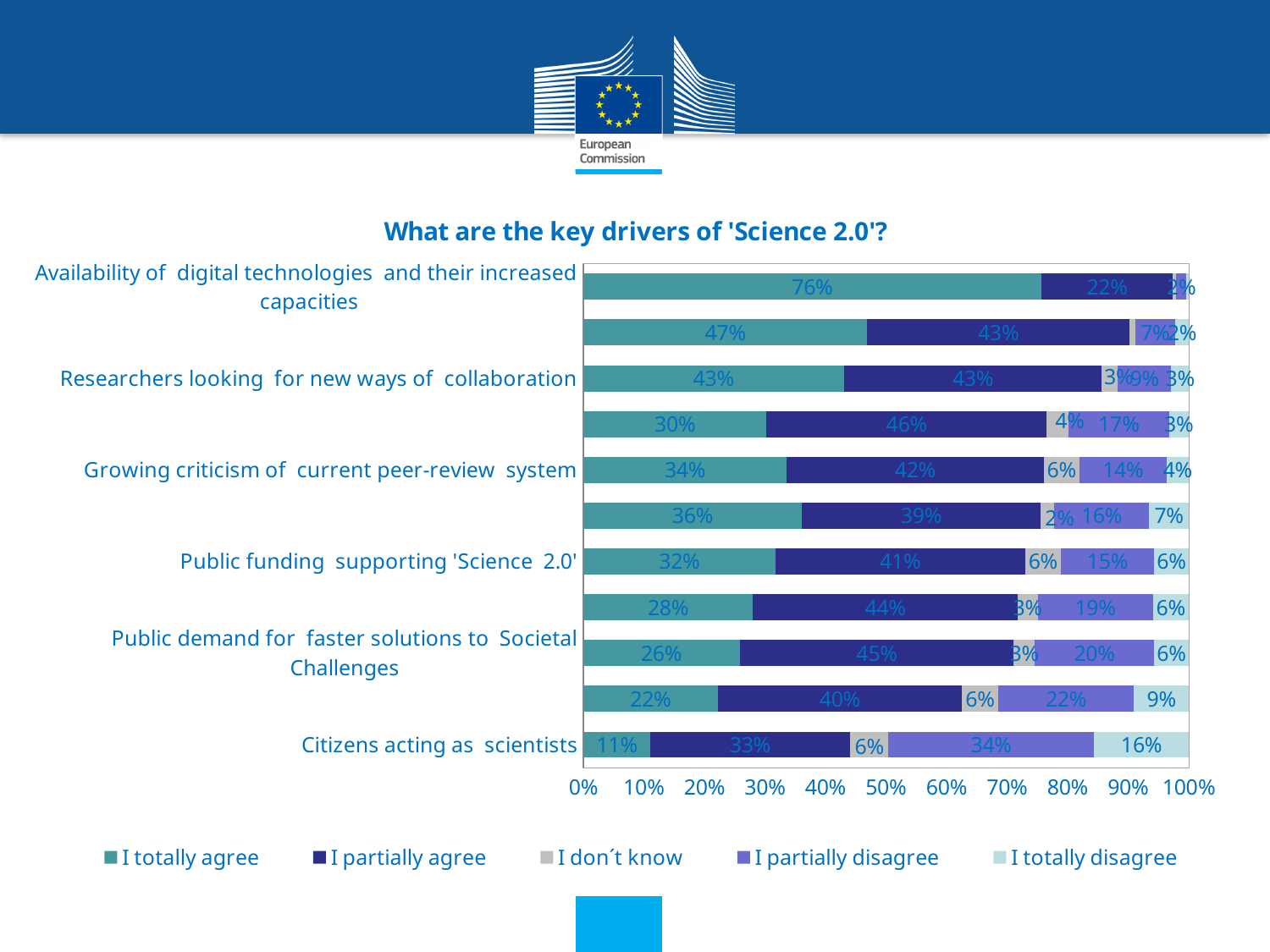
Which has a larger 'I totally disagree' share: 'Citizens acting as scientists' or 'Public funding supporting 'Science 2.0''? Citizens acting as scientists What is the 'I totally agree' value for 'Citizens acting as scientists'? 11% Which driver has the lowest 'I totally agree' share? Citizens acting as scientists What is the title of the chart? What are the key drivers of 'Science 2.0'? How many series does the legend list? 5 Which driver has the highest 'I totally agree' share? Availability of digital technologies and their increased capacities What type of chart is shown on the slide? Stacked bar chart What percentage of respondents totally agree that 'Availability of digital technologies and their increased capacities' is a key driver? 76% What is the 'I partially disagree' value for 'Citizens acting as scientists'? 34% What is the 'I partially agree' value for 'Public demand for faster solutions to Societal Challenges'? 45% How many bars are plotted in the chart? 11 What is the difference in 'I totally agree' share between 'Availability of digital technologies and their increased capacities' and 'Citizens acting as scientists'? 65 percentage points